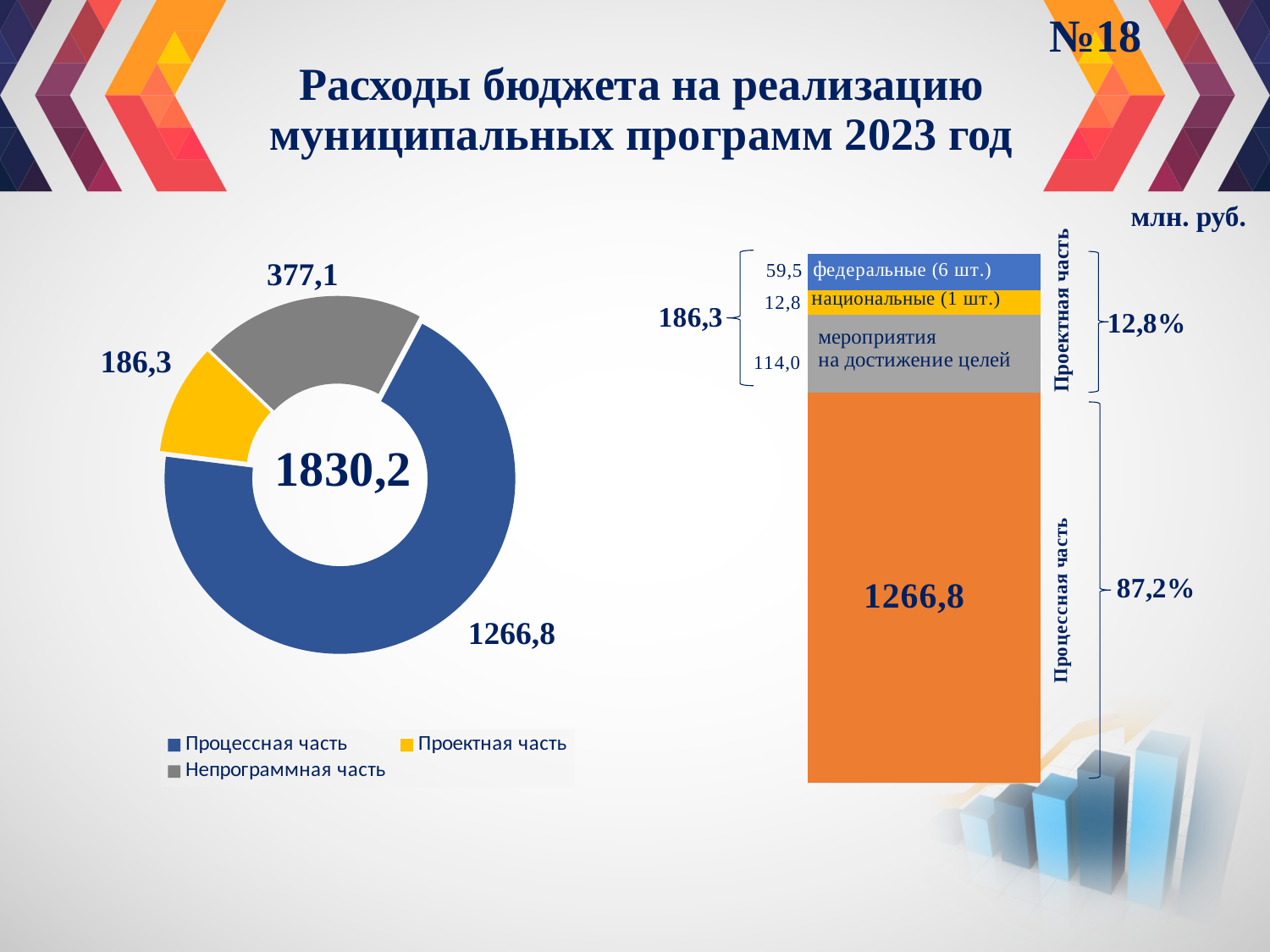
On the donut chart on the left, what is the difference between Непрограммная часть and Проектная часть? 190,8 On the donut chart on the left, which category has the largest value? Процессная часть On the stacked bar chart on the right, what percentage share is shown for Процессная часть? 87,2% On the donut chart on the left, what is the value for Непрограммная часть? 377,1 What total value is shown in the centre of the donut chart on the left? 1830,2 On the stacked bar chart on the right, what is the value for мероприятия на достижение целей? 114,0 On the donut chart on the left, what is the value for Процессная часть? 1266,8 On the stacked bar chart on the right, what is the total of the three segments making up Проектная часть? 186,3 On the donut chart on the left, what is the value for Проектная часть? 186,3 On the stacked bar chart on the right, what is the value for федеральные (6 шт.)? 59,5 On the donut chart on the left, how many categories does the legend list? 3 On the donut chart on the left, which category has the smallest value? Проектная часть